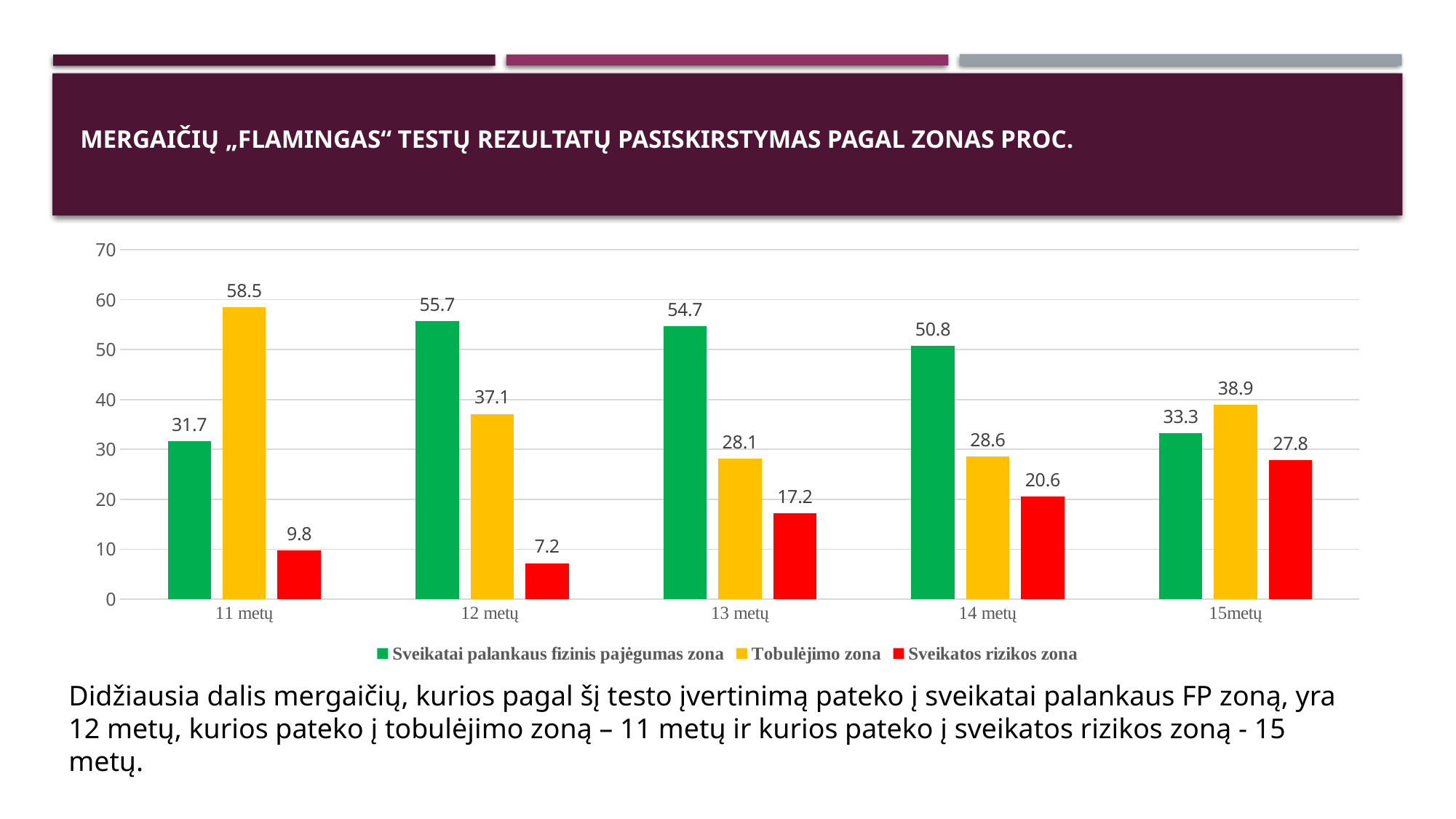
How many age groups are shown on the x axis? 5 What is the value for "Sveikatai palankaus fizinis pajėgumas zona" at 14 metų? 50.8 Which colour represents "Sveikatos rizikos zona" in the chart? red What is the value for "Tobulėjimo zona" at 11 metų? 58.5 Is the value for "Sveikatai palankaus fizinis pajėgumas zona" at 11 metų greater or less than 40? less How many series does the legend list? 3 What kind of chart is shown on the slide? bar chart Which age group has the highest value for "Sveikatai palankaus fizinis pajėgumas zona"? 12 metų What is the value for "Sveikatos rizikos zona" at 13 metų? 17.2 Which is larger at 13 metų: "Tobulėjimo zona" or "Sveikatos rizikos zona"? Tobulėjimo zona What is the difference between the "Tobulėjimo zona" value and the "Sveikatos rizikos zona" value at 15metų? 11.1 Which age group has the lowest value for "Sveikatos rizikos zona"? 12 metų